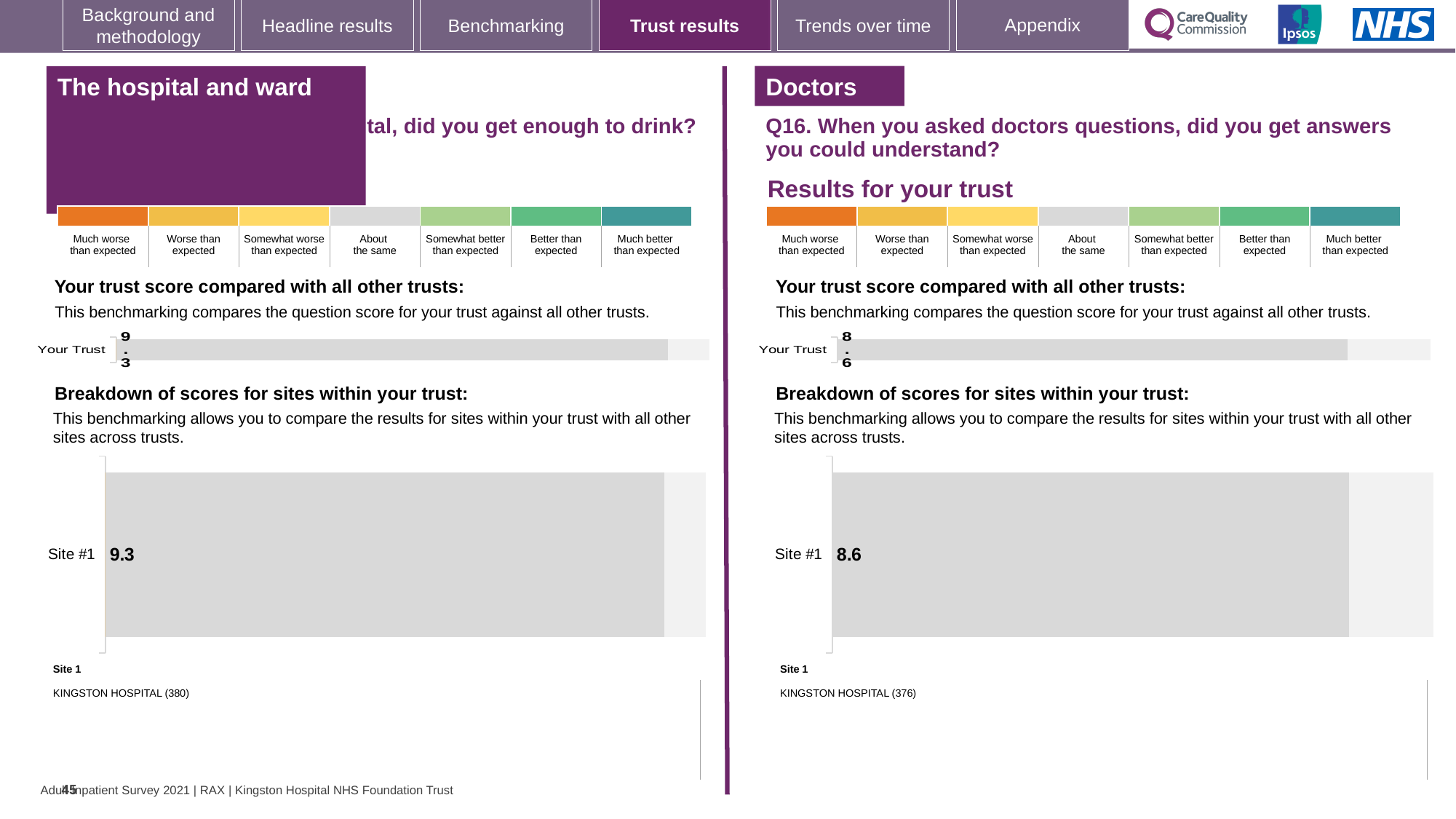
What type of chart is used to show the Your Trust score on the left-hand chart? Bar chart On the right-hand 'Breakdown of scores for sites within your trust' chart (Doctors, Q16), what is the score for Site #1? 8.6 What type of chart is used to show the Site #1 score on the right-hand breakdown chart? Bar chart On the left-hand 'Breakdown of scores for sites within your trust' chart, what is the score for Site #1? 9.3 On the right-hand breakdown chart, which site name is listed as Site 1 below the chart? KINGSTON HOSPITAL (376) On the right-hand 'Your trust score compared with all other trusts' chart (Doctors, Q16), what is the score shown for Your Trust? 8.6 How many sites are plotted on the right-hand 'Breakdown of scores for sites within your trust' chart? 1 On the left-hand breakdown chart, which site name is listed as Site 1 below the chart? KINGSTON HOSPITAL (380) How many sites are plotted on the left-hand 'Breakdown of scores for sites within your trust' chart? 1 What is the difference between the Your Trust score on the left-hand chart and the Your Trust score on the right-hand chart? 0.7 Which is larger: the Site #1 score on the left-hand breakdown chart or the Site #1 score on the right-hand breakdown chart? Left-hand (9.3) On the left-hand 'Your trust score compared with all other trusts' chart, what is the score shown for Your Trust? 9.3